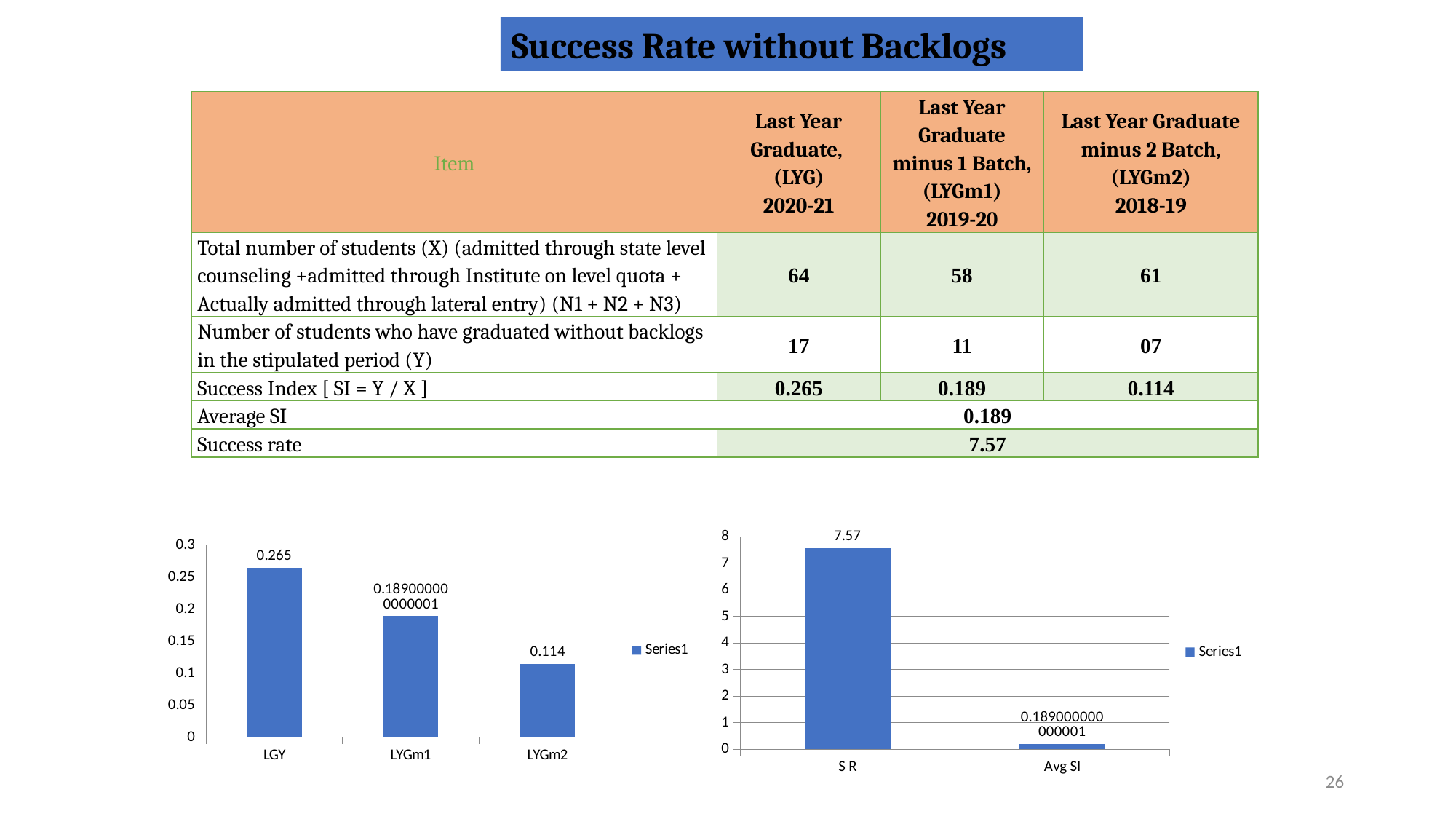
In the right chart, which is larger, S R or Avg SI? S R How many series does the legend of the right chart list? 1 In the left chart, what is the difference between the values for LGY and LYGm2? 0.151 In the left chart, do the values rise or fall from LGY to LYGm2? fall What type of chart is the left chart on the slide? bar chart In the left chart, which category has the highest value? LGY How many categories are shown in the left chart? 3 In the left chart, what is the value for LYGm2? 0.114 In the left chart, what is the value for LGY? 0.265 In the left chart, which category has the lowest value? LYGm2 In the right chart, what is the value for S R? 7.57 In the right chart, is the value for Avg SI greater or less than 1? less